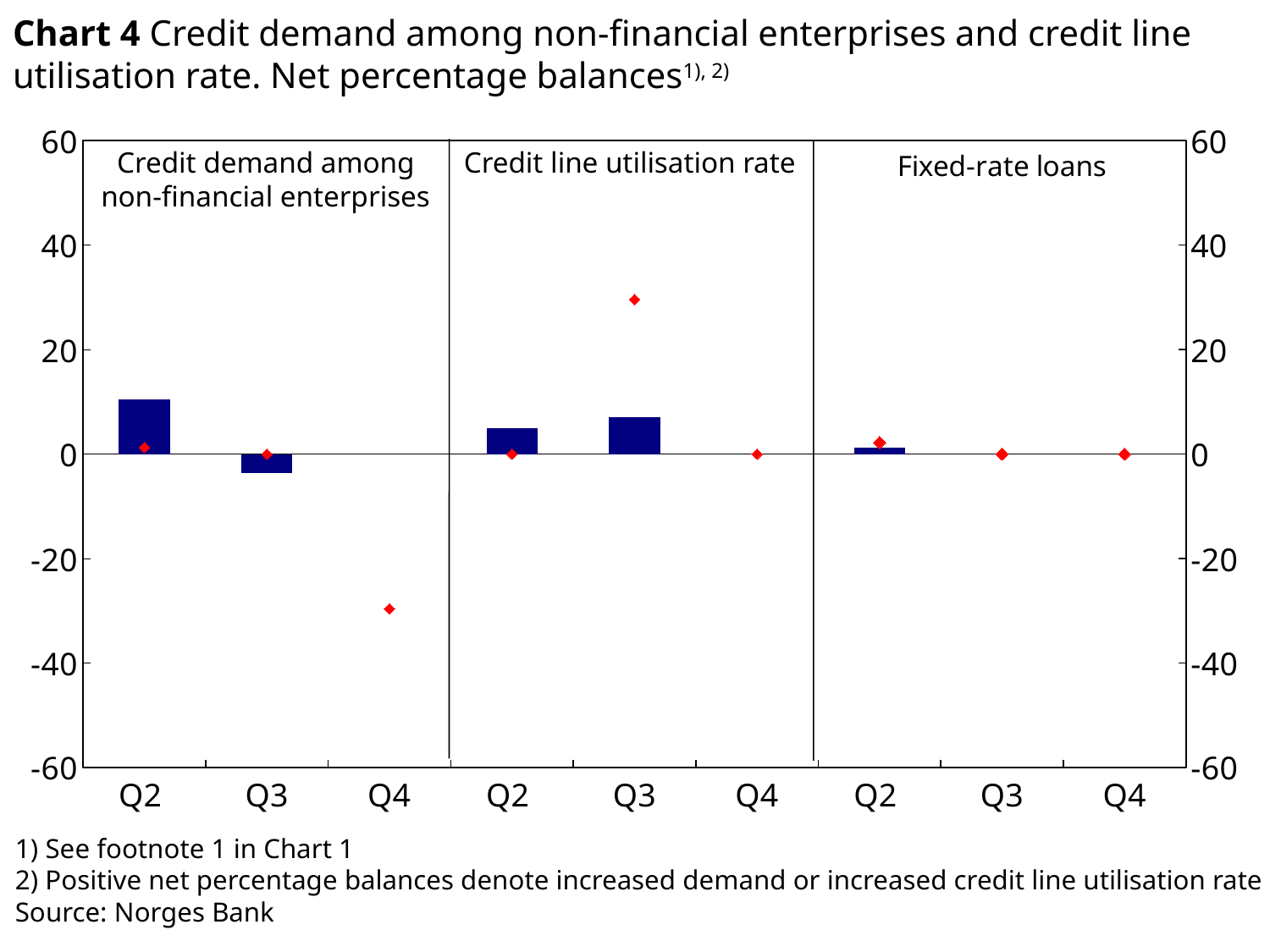
In the 'Credit line utilisation rate' panel, is the red marker for Q3 greater or less than 20? greater How many quarters are shown on the x axis of each panel in Chart 4? 3 In the 'Credit demand among non-financial enterprises' panel, which quarter has the lowest bar? Q3 How many panels does Chart 4 contain? 3 In the 'Credit demand among non-financial enterprises' panel, which quarter has the highest bar? Q2 In the 'Credit demand among non-financial enterprises' panel, is the Q3 bar greater or less than 0? less What is the title of the rightmost panel in Chart 4? Fixed-rate loans In the 'Credit demand among non-financial enterprises' panel, do the bars rise or fall from Q2 to Q3? fall In the 'Credit demand among non-financial enterprises' panel, is the Q2 bar greater or less than 20? less In the 'Credit line utilisation rate' panel, which bar is taller, Q2 or Q3? Q3 What kind of chart is Chart 4? combination bar and line chart (bars with red diamond markers)